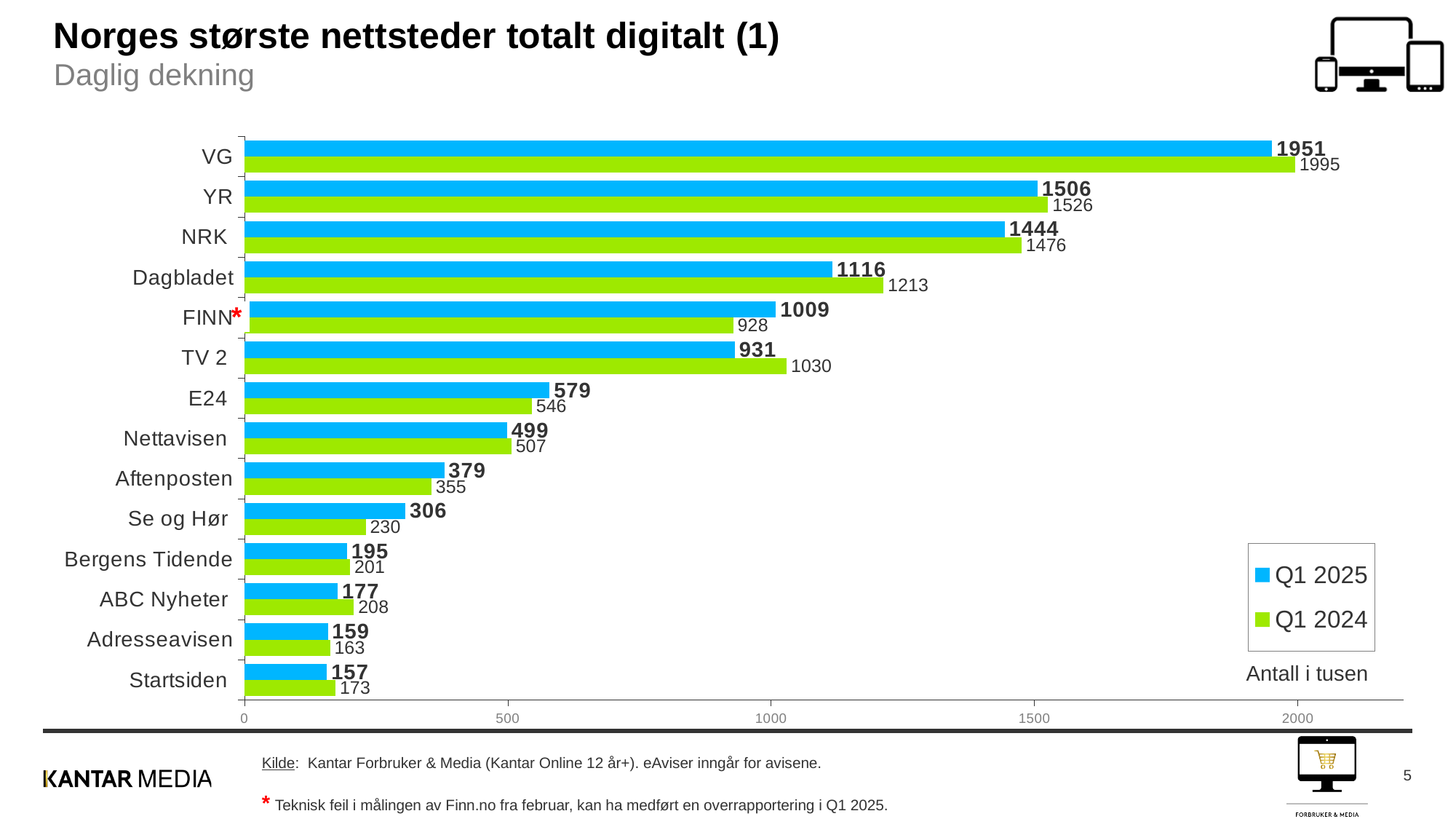
What is the Q1 2025 value for VG? 1951 What is the Q1 2024 value for Dagbladet? 1213 How many websites are shown on the chart? 14 Is the Q1 2025 value for NRK greater or less than 1500? less Which website has the highest Q1 2025 value? VG How many series does the legend list? 2 Which is larger for FINN: the Q1 2025 value or the Q1 2024 value? Q1 2025 What is the Q1 2025 value for Se og Hør? 306 Which website has the lowest Q1 2025 value? Startsiden What is the difference between the Q1 2024 and Q1 2025 values for TV 2? 99 What unit note is shown below the legend? Antall i tusen What kind of chart is shown on the slide? bar chart